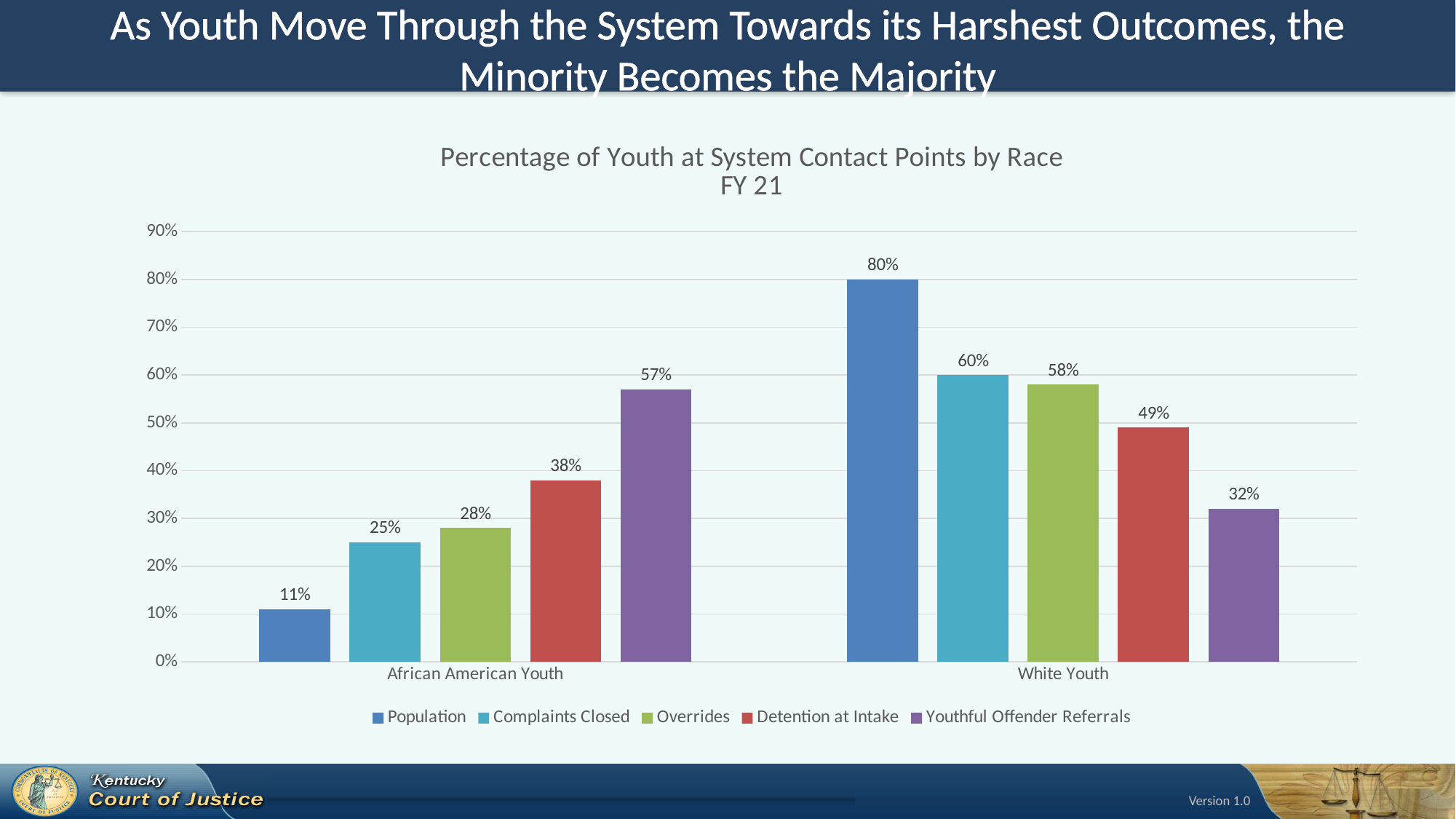
How many categories are shown on the x axis? 2 Which series has the lowest value for African American Youth? Population Is the Complaints Closed value for White Youth greater or less than 50%? greater What is the Youthful Offender Referrals value for White Youth? 32% What is the Population value for African American Youth? 11% What kind of chart is shown on the slide? Bar chart Which is larger: Overrides for African American Youth or Overrides for White Youth? White Youth What is the difference between the Youthful Offender Referrals values for African American Youth and White Youth? 25% What is the title of the chart? Percentage of Youth at System Contact Points by Race FY 21 Which series has the highest value for White Youth? Population What is the Detention at Intake value for African American Youth? 38% How many series does the legend list? 5